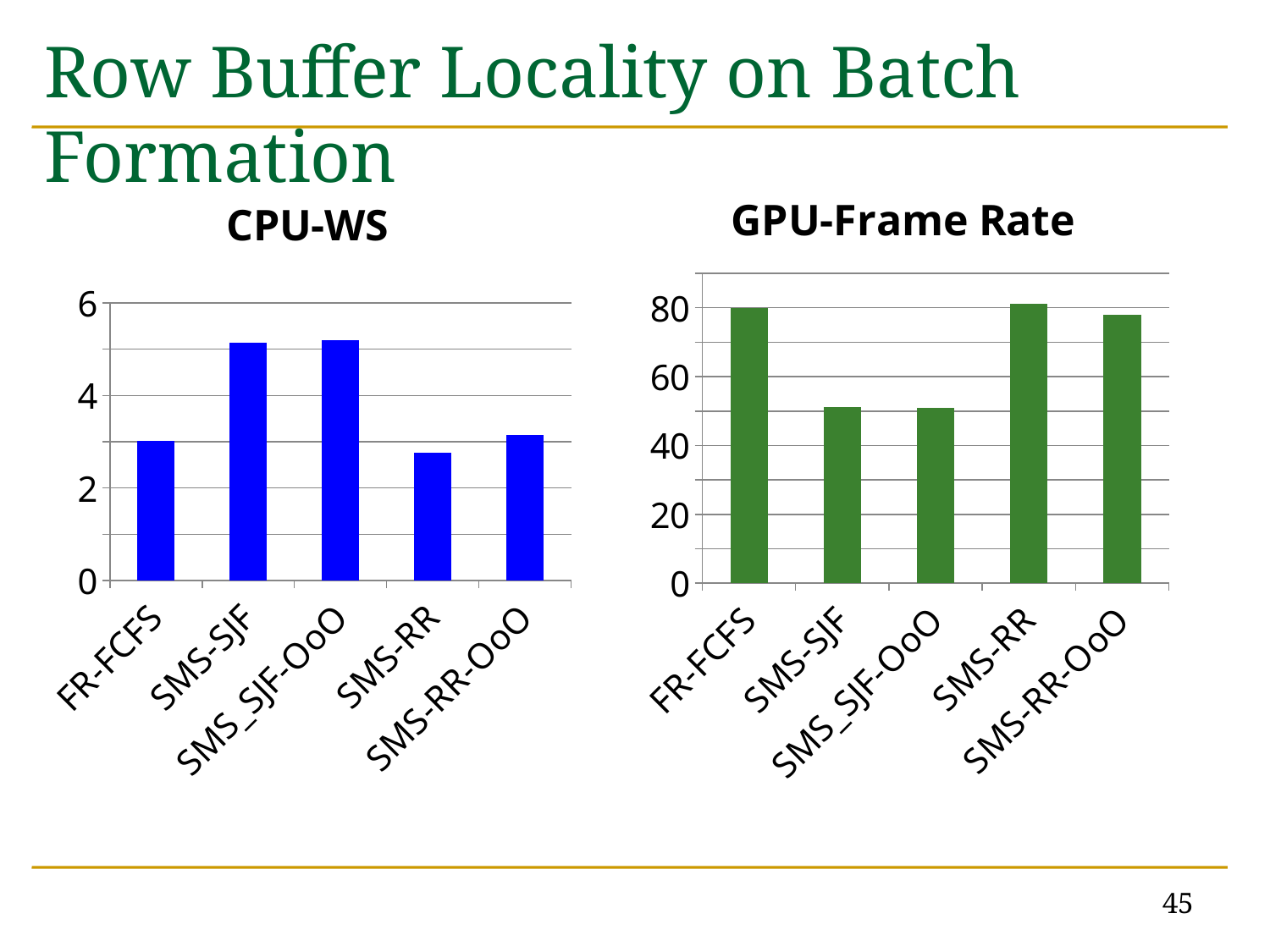
How many bars does the CPU-WS chart have? 5 In the CPU-WS chart, is the value for SMS-RR greater or less than 4? less In the GPU-Frame Rate chart, which is larger, FR-FCFS or SMS-SJF? FR-FCFS In the CPU-WS chart, is the value for SMS-SJF greater or less than 4? greater In the GPU-Frame Rate chart, is the value for SMS-SJF greater or less than 60? less How many categories are shown on the GPU-Frame Rate chart? 5 What is the title of the chart on the left of the slide? CPU-WS In the CPU-WS chart, which is larger, SMS-SJF or SMS-RR? SMS-SJF What kind of chart is the CPU-WS chart? bar chart What colour are the bars in the GPU-Frame Rate chart? green